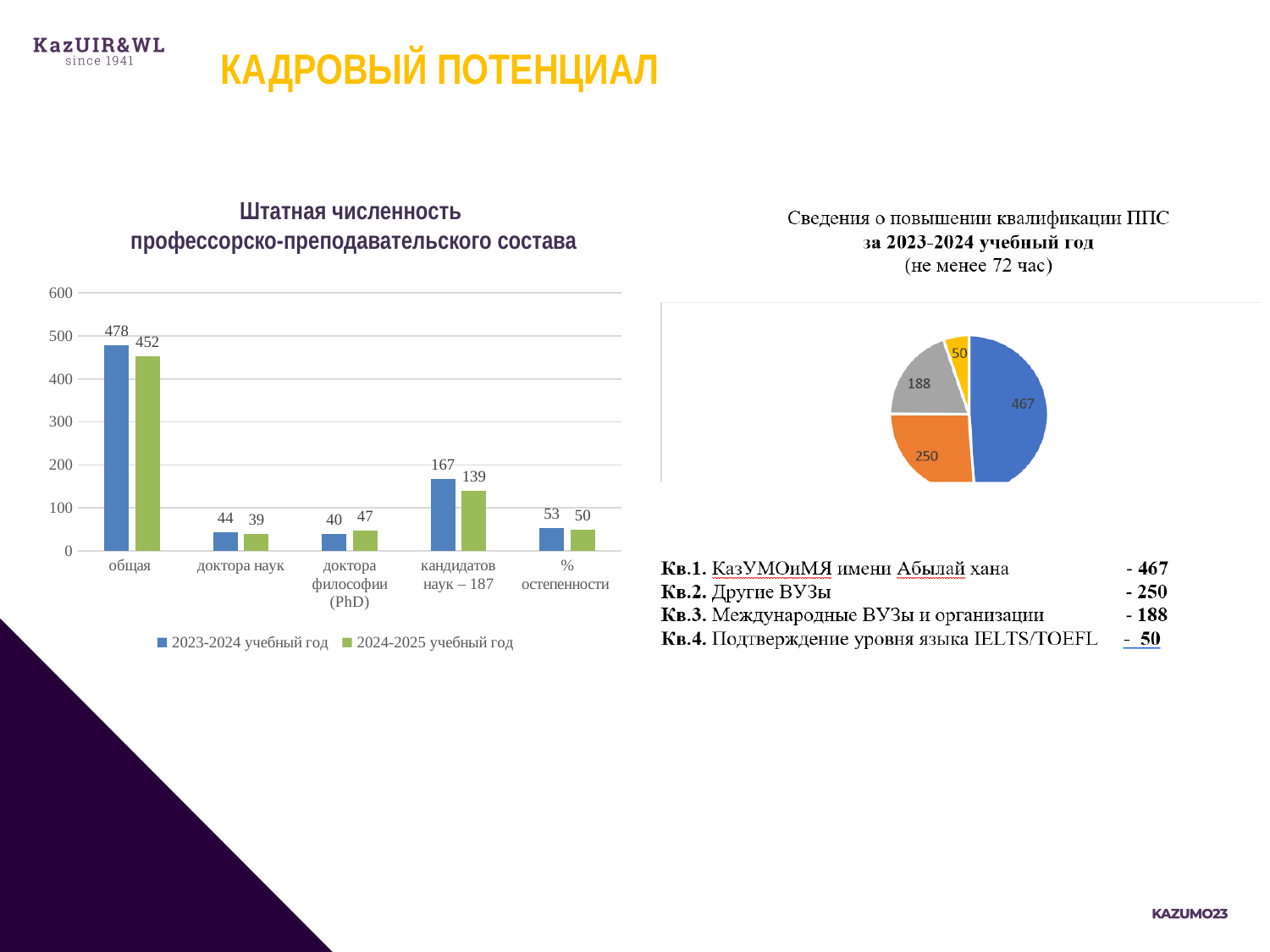
In the bar chart 'Штатная численность профессорско-преподавательского состава', what is the value for 'доктора философии (PhD)' in the 2024-2025 учебный год series? 47 In the bar chart 'Штатная численность профессорско-преподавательского состава', which colour represents the 2024-2025 учебный год series? green In the bar chart 'Штатная численность профессорско-преподавательского состава', which is larger for 'доктора наук': the 2023-2024 value or the 2024-2025 value? 2023-2024 учебный год How many series does the legend of the bar chart 'Штатная численность профессорско-преподавательского состава' list? 2 How many categories are shown on the x axis of the bar chart 'Штатная численность профессорско-преподавательского состава'? 5 How many slices does the pie chart 'Сведения о повышении квалификации ППС за 2023-2024 учебный год' have? 4 In the bar chart 'Штатная численность профессорско-преподавательского состава', what is the value for 'общая' in the 2023-2024 учебный год series? 478 What kind of chart is the chart on the left titled 'Штатная численность профессорско-преподавательского состава'? bar chart In the pie chart 'Сведения о повышении квалификации ППС за 2023-2024 учебный год', what is the value of the smallest slice? 50 In the bar chart 'Штатная численность профессорско-преподавательского состава', what is the difference between the 2023-2024 and 2024-2025 values for 'кандидатов наук – 187'? 28 In the pie chart 'Сведения о повышении квалификации ППС за 2023-2024 учебный год', what is the value of the largest slice? 467 In the bar chart 'Штатная численность профессорско-преподавательского состава', which category has the lowest value in the 2023-2024 учебный год series? доктора философии (PhD)